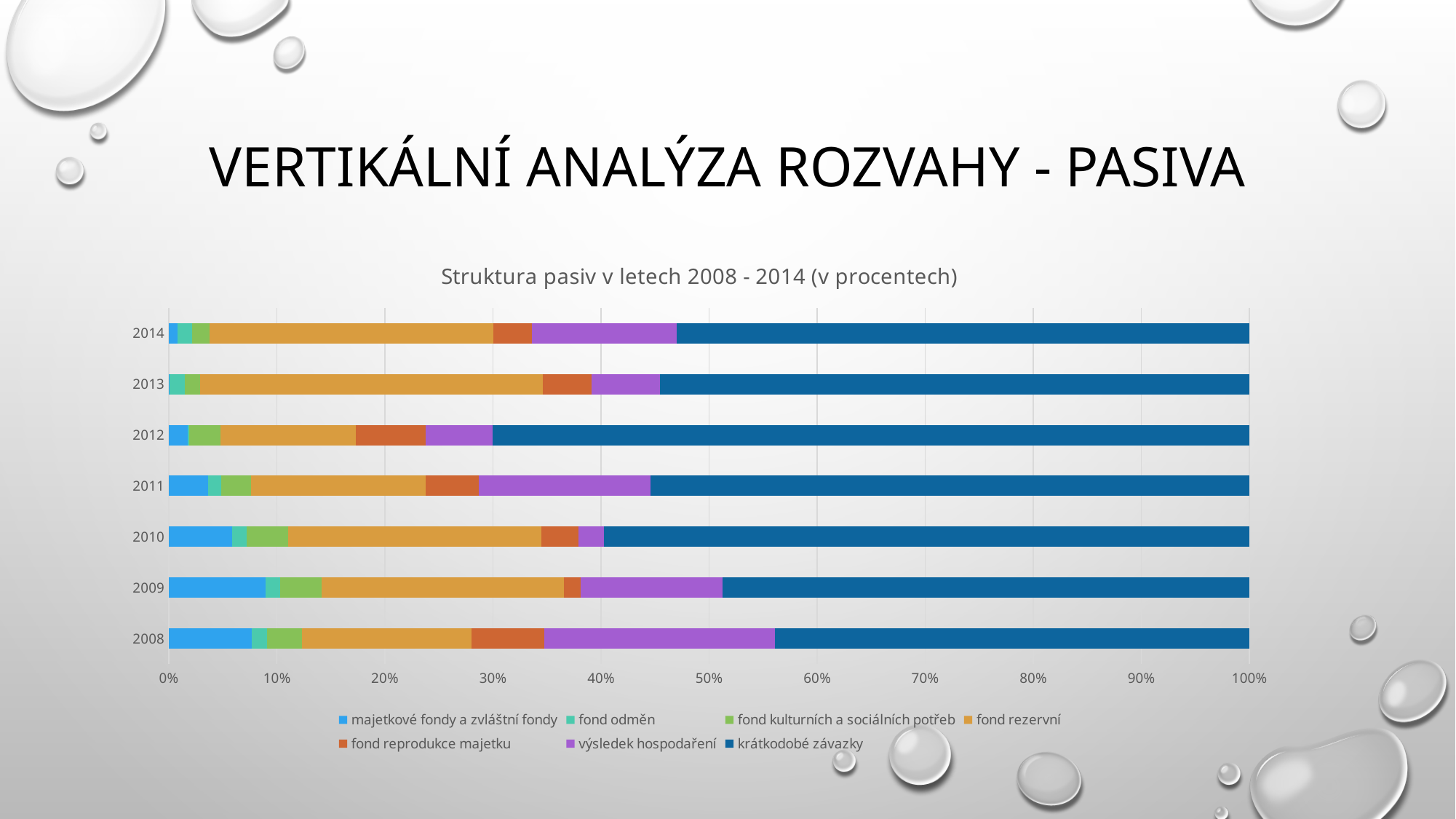
Which year has the larger fond rezervní segment, 2013 or 2012? 2013 What kind of chart is shown on the slide? Stacked bar chart Is the share of krátkodobé závazky in 2012 greater or less than 60%? greater Is the share of krátkodobé závazky in 2008 greater or less than 50%? less In which year is the krátkodobé závazky segment the smallest? 2008 Which series is shown in dark blue in the legend? krátkodobé závazky What is the total of each stacked bar on the chart? 100% In which year is the krátkodobé závazky segment the largest? 2012 How many series does the legend list? 7 What is the title of the chart? Struktura pasiv v letech 2008 - 2014 (v procentech) How many years (categories) are plotted on the chart? 7 In which year is the výsledek hospodaření segment the largest? 2008